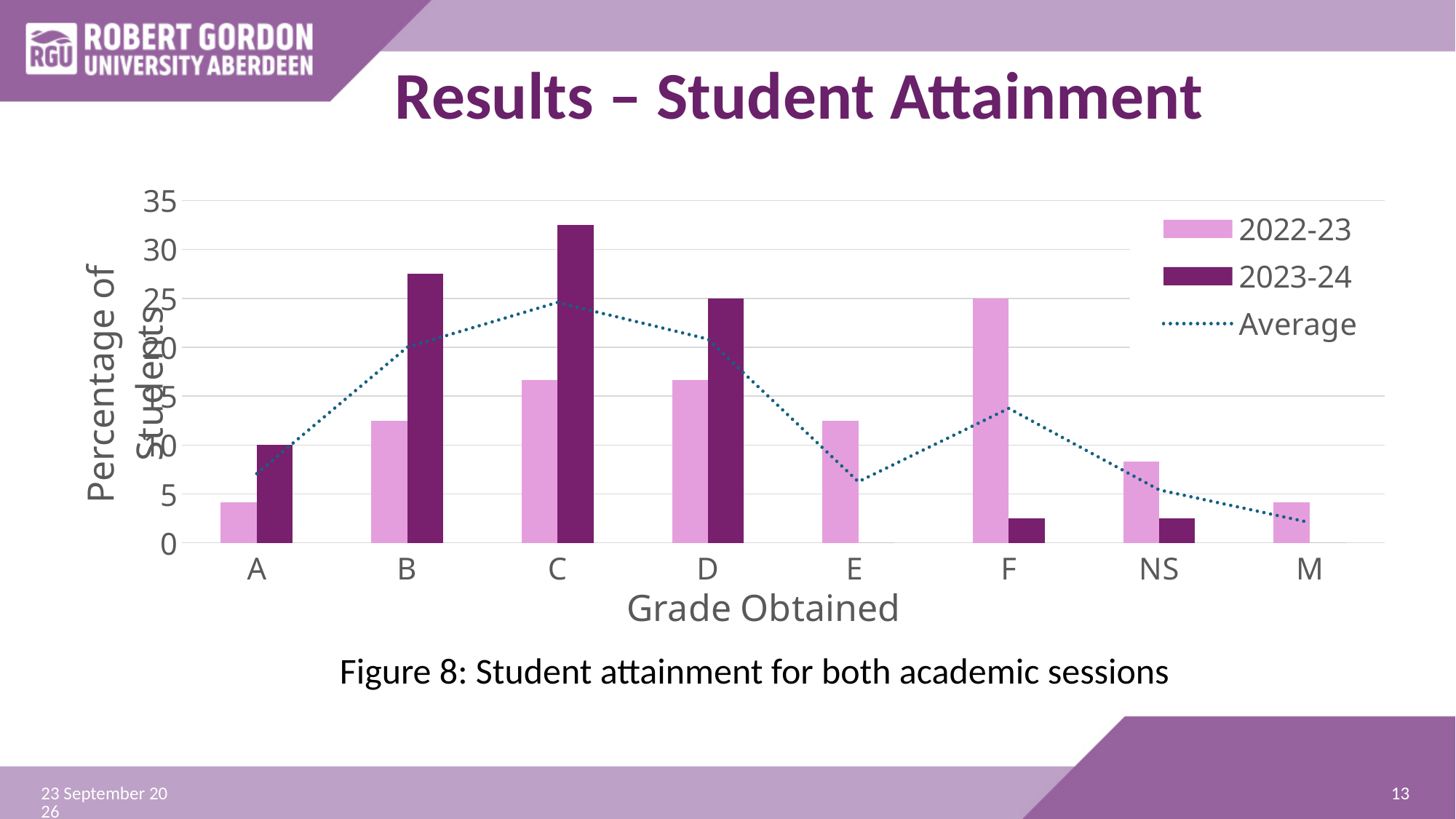
Is the 2023-24 value for grade C greater or less than 30? greater Is the 2023-24 value for grade B greater or less than 25? greater Is the 2022-23 value for grade A greater or less than 5? less How many grade categories are shown on the x axis? 8 For grade B, which series has the larger value, 2022-23 or 2023-24? 2023-24 What kind of chart is shown on the slide? combination bar and line chart Which grade has the highest value for the 2023-24 series? C For grade F, which series has the larger value, 2022-23 or 2023-24? 2022-23 What is the title of the x axis? Grade Obtained Which grade has the highest value for the 2022-23 series? F How many series does the legend list? 3